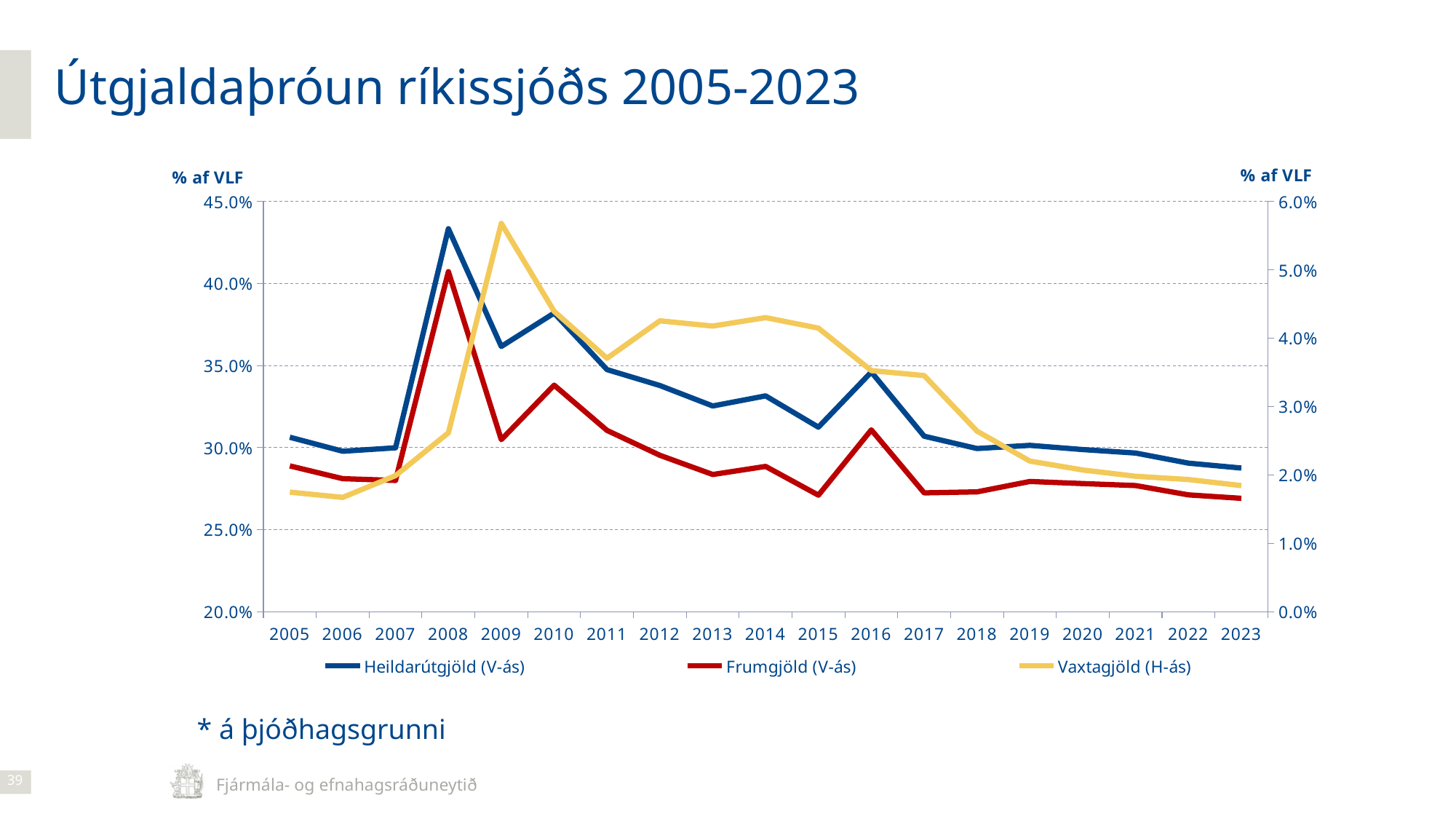
In which year does Frumgjöld (V-ás) reach its highest value? 2008 Is the value for Heildarútgjöld (V-ás) in 2008 greater or less than 40.0%? greater What kind of chart is shown on the slide? line chart In which year does Heildarútgjöld (V-ás) reach its highest value? 2008 How many series does the legend list? 3 Is the value for Vaxtagjöld (H-ás) in 2009 greater or less than 5.0%? greater In which year does Vaxtagjöld (H-ás) reach its highest value? 2009 How many years are plotted along the x axis? 19 Which is larger for Frumgjöld (V-ás): the value in 2016 or the value in 2017? 2016 In which year is Heildarútgjöld (V-ás) at its lowest? 2023 Does Heildarútgjöld (V-ás) rise or fall from 2016 to 2023? fall Is the value for Frumgjöld (V-ás) in 2015 greater or less than 30.0%? less